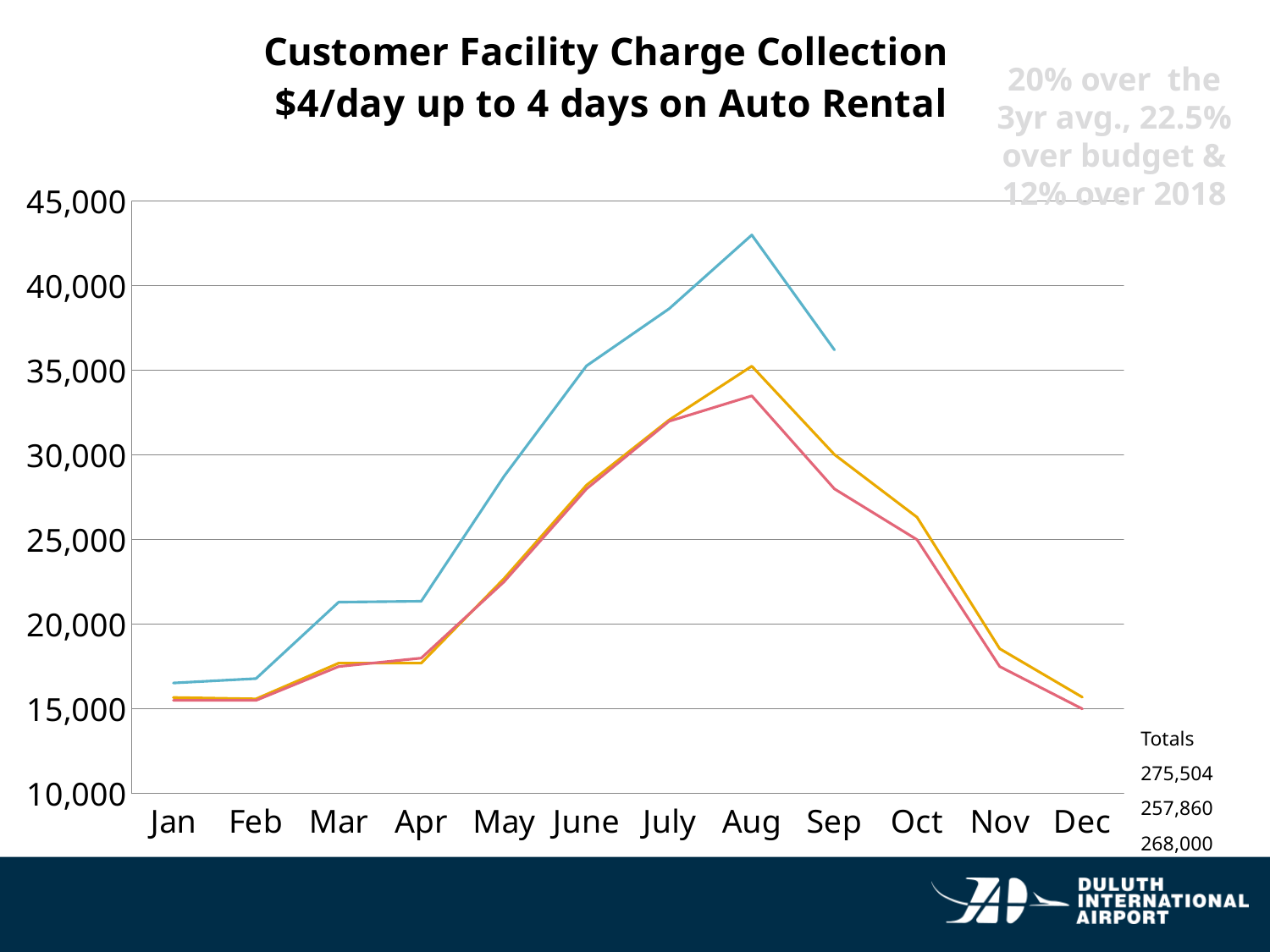
How many months are shown on the x axis of the chart? 12 In which month does the blue line reach its highest value? Aug What is the title of the chart? Customer Facility Charge Collection $4/day up to 4 days on Auto Rental How many lines are plotted on the chart? 3 What kind of chart is shown on the slide? line chart Does the blue line rise or fall from Apr to Aug? rise Is the value of the blue line in Jan greater or less than 20,000? less Is the value of the blue line in Mar greater or less than 20,000? greater In Aug, which line has the higher value, the blue line or the pink line? blue line Is the value of the blue line in Aug greater or less than 40,000? greater In which month does the yellow line reach its highest value? Aug